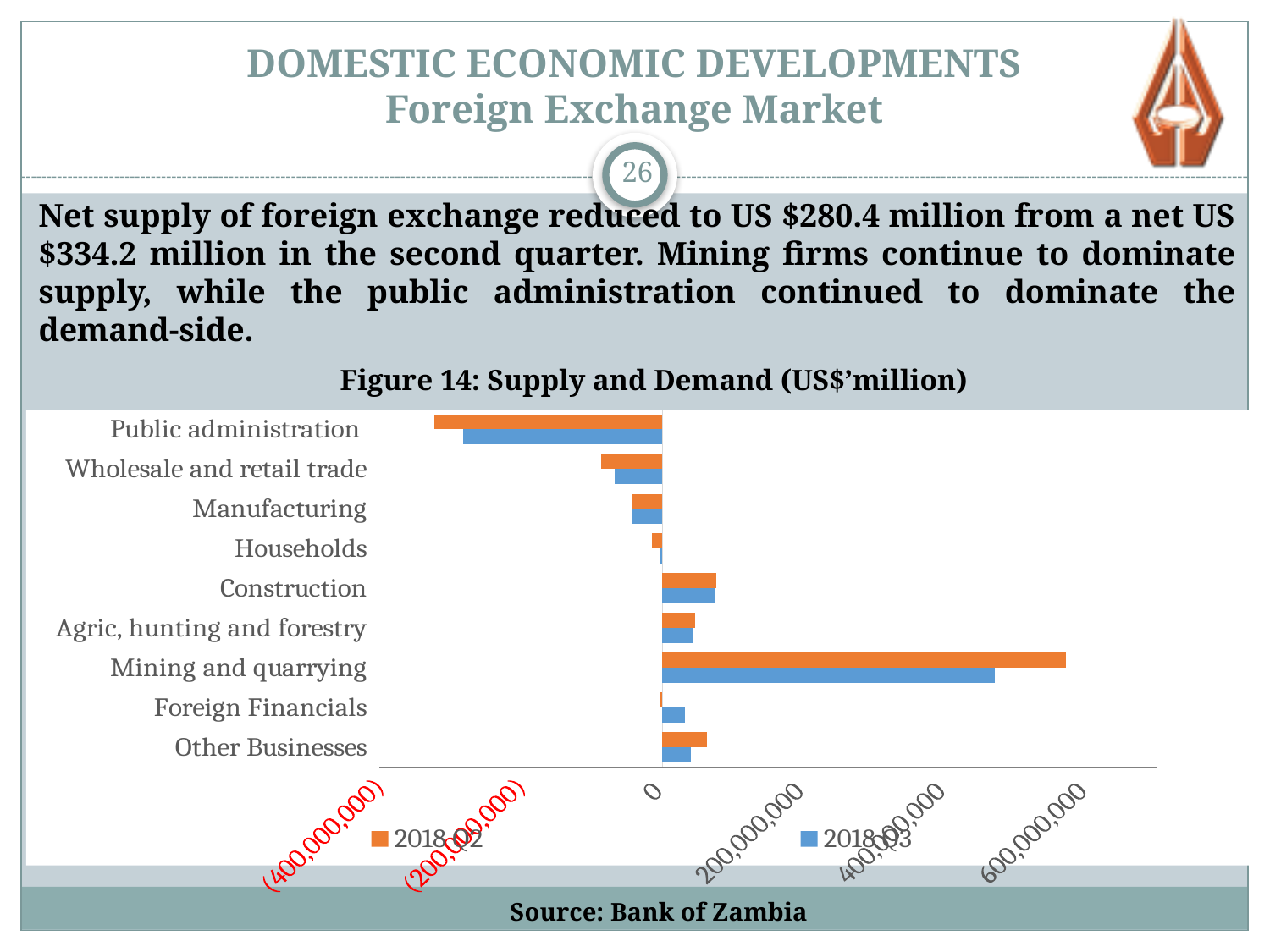
Is the value for Mining and quarrying in 2018 Q3 greater or less than 400,000,000? greater Which category has the highest value for 2018 Q2? Mining and quarrying For Foreign Financials, which series has the larger value, 2018 Q2 or 2018 Q3? 2018 Q3 Which category has the lowest (most negative) value for 2018 Q2? Public administration What is the title of the chart? Figure 14: Supply and Demand (US$'million) Which category has the highest value for 2018 Q3? Mining and quarrying Is the value for Public administration in 2018 Q2 greater or less than (200,000,000)? less How many series does the chart legend list? 2 What source is cited for the chart? Bank of Zambia For Mining and quarrying, which series has the larger value, 2018 Q2 or 2018 Q3? 2018 Q2 What kind of chart is Figure 14? bar chart How many categories are shown on the y axis of the chart? 9